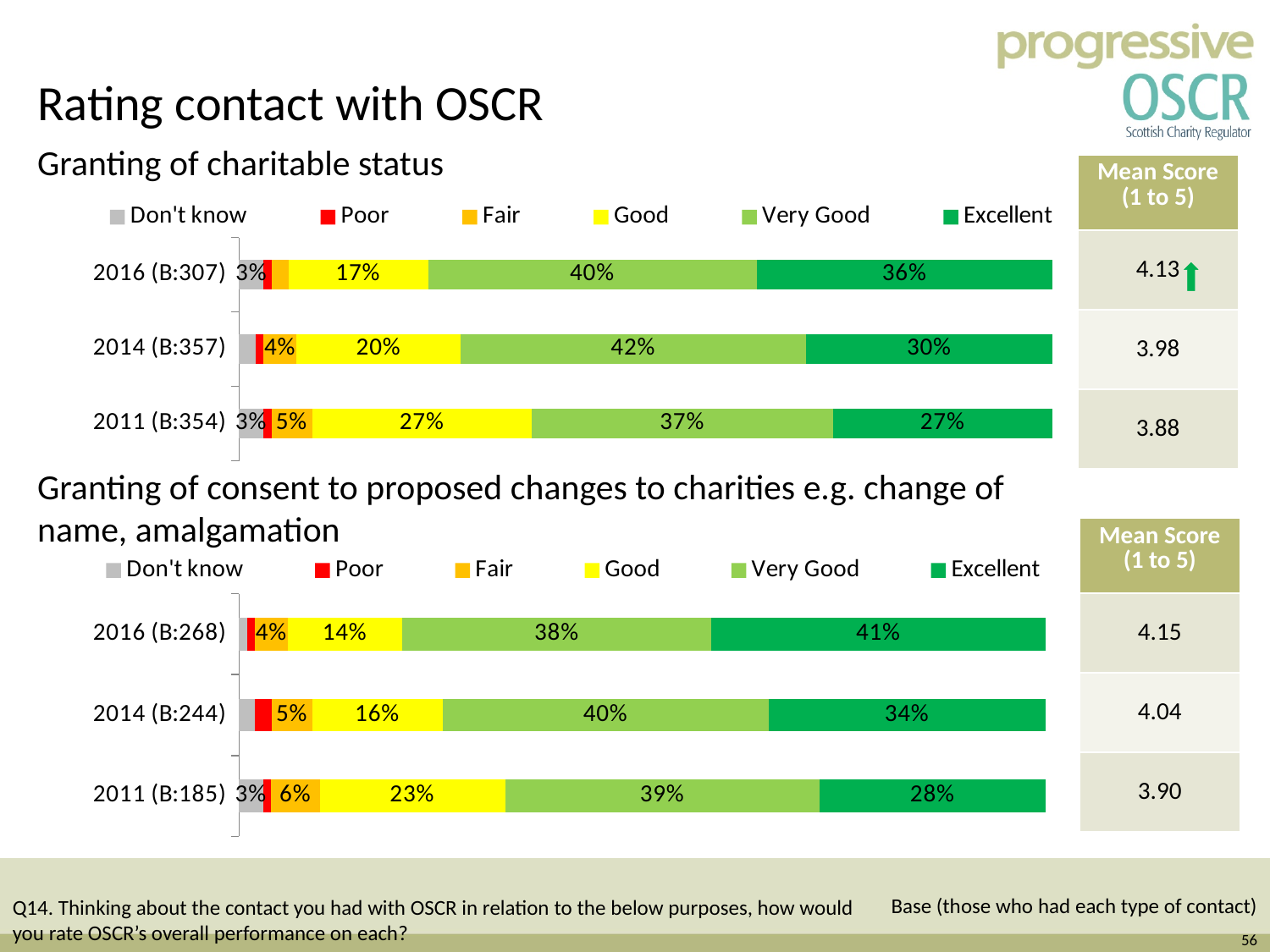
In the 'Granting of charitable status' chart, how many series does the legend list? 6 In the 'Granting of consent to proposed changes to charities' chart, which year has the lowest Excellent percentage? 2011 (B:185) In the 'Granting of consent to proposed changes to charities' chart, what percentage rated it Fair in 2011 (B:185)? 6% How many year categories are shown in the 'Granting of charitable status' chart? 3 In the 'Granting of consent to proposed changes to charities' chart, is the Good percentage larger in 2014 (B:244) or 2011 (B:185)? 2011 (B:185) What type of chart is used for 'Granting of consent to proposed changes to charities'? Stacked bar chart In the 'Granting of consent to proposed changes to charities' chart, what is the difference between the Very Good percentages for 2014 (B:244) and 2016 (B:268)? 2% In the 'Granting of charitable status' chart, what is the difference between the Excellent percentages for 2016 (B:307) and 2011 (B:354)? 9% In the 'Granting of charitable status' chart, which year has the highest Very Good percentage? 2014 (B:357) In the 'Granting of charitable status' chart, what percentage rated it Good in 2011 (B:354)? 27% In the 'Granting of consent to proposed changes to charities' chart, what percentage rated it Excellent in 2016 (B:268)? 41% In the 'Granting of charitable status' chart, what percentage rated it Excellent in 2016 (B:307)? 36%